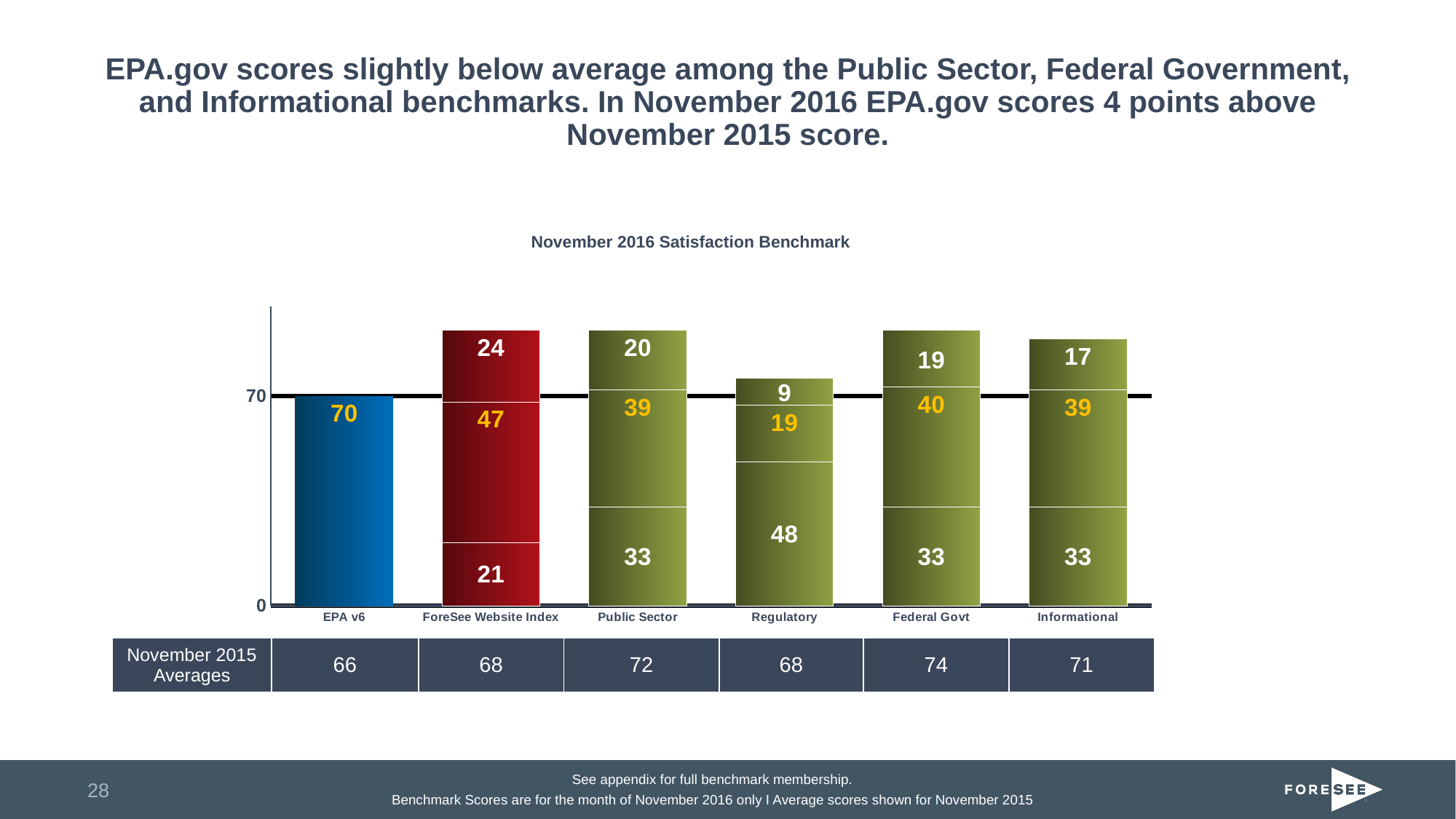
What is the value of the bottom segment of the Regulatory bar? 48 Which is larger: the top segment of the ForeSee Website Index bar or the top segment of the Informational bar? ForeSee Website Index What is the difference between the bottom segment of the Regulatory bar (48) and the bottom segment of the Public Sector bar (33)? 15 How many categories are shown along the x axis of the chart? 6 What is the value of the top segment of the ForeSee Website Index bar? 24 What kind of chart is shown on the slide? Stacked bar chart What is the chart's title? November 2016 Satisfaction Benchmark What is the November 2015 average shown for Federal Govt in the table below the chart? 74 What is the value of the middle segment of the Federal Govt bar? 40 Which category has the largest bottom segment? Regulatory Which category has the smallest top segment? Regulatory What is the value labelled on the EPA v6 bar? 70